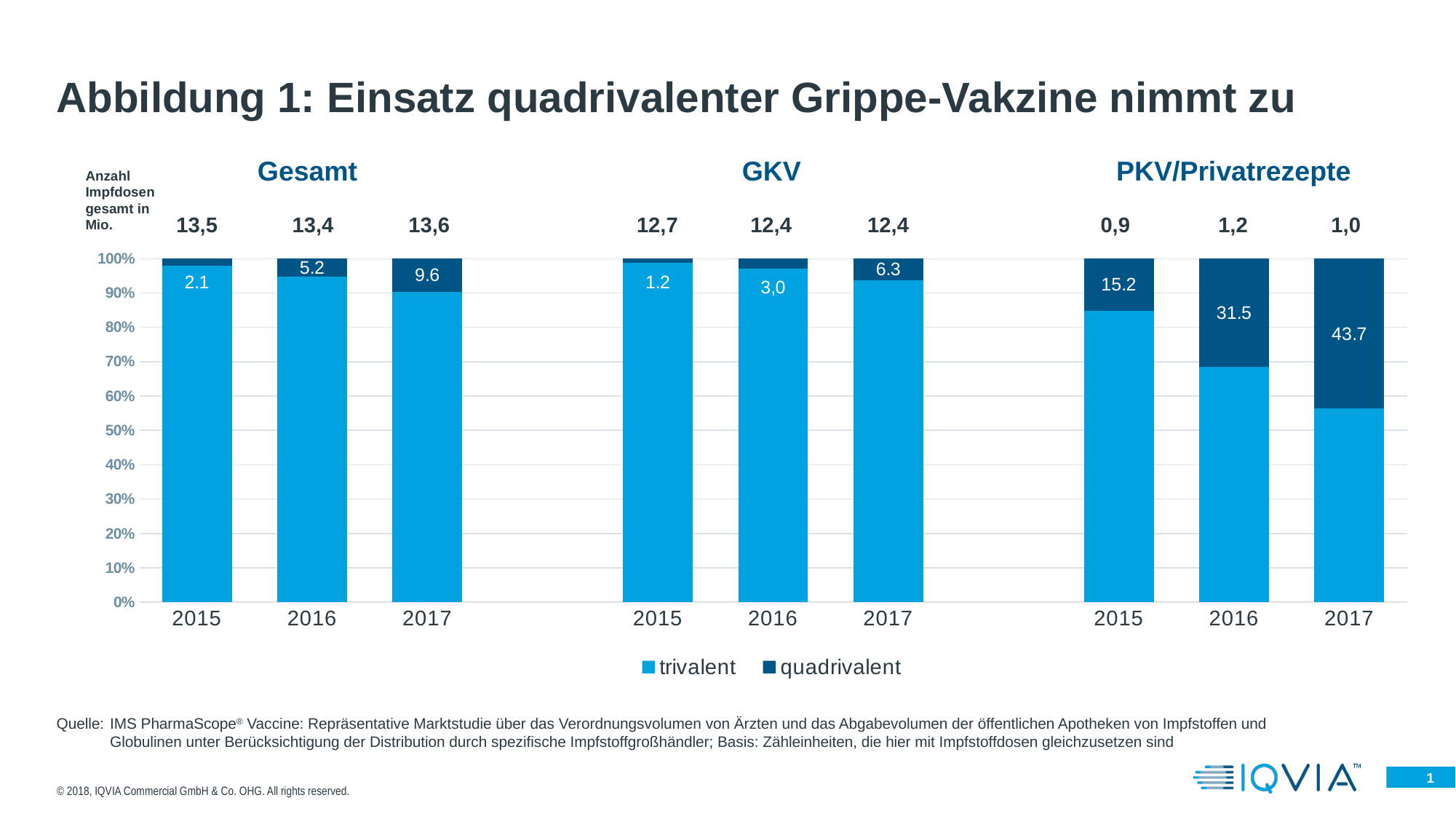
What is the quadrivalent share label for Gesamt in 2017? 9.6 Which is larger, the quadrivalent share label for Gesamt 2016 or for GKV 2017? GKV 2017 What is the total number of vaccine doses in millions shown above the PKV/Privatrezepte 2017 bar? 1,0 Does the quadrivalent share rise or fall from 2015 to 2017 within each group? rise Which bar has the highest quadrivalent share label? PKV/Privatrezepte 2017 How many series does the legend list? 2 What is the total number of vaccine doses in millions shown above the Gesamt 2015 bar? 13,5 What is the quadrivalent share label for GKV in 2016? 3,0 Which bar has the lowest quadrivalent share label? GKV 2015 What kind of chart is shown on the slide? stacked bar chart What is the difference between the quadrivalent share labels for PKV/Privatrezepte in 2017 and 2016? 12.2 What is the quadrivalent share label for PKV/Privatrezepte in 2016? 31.5